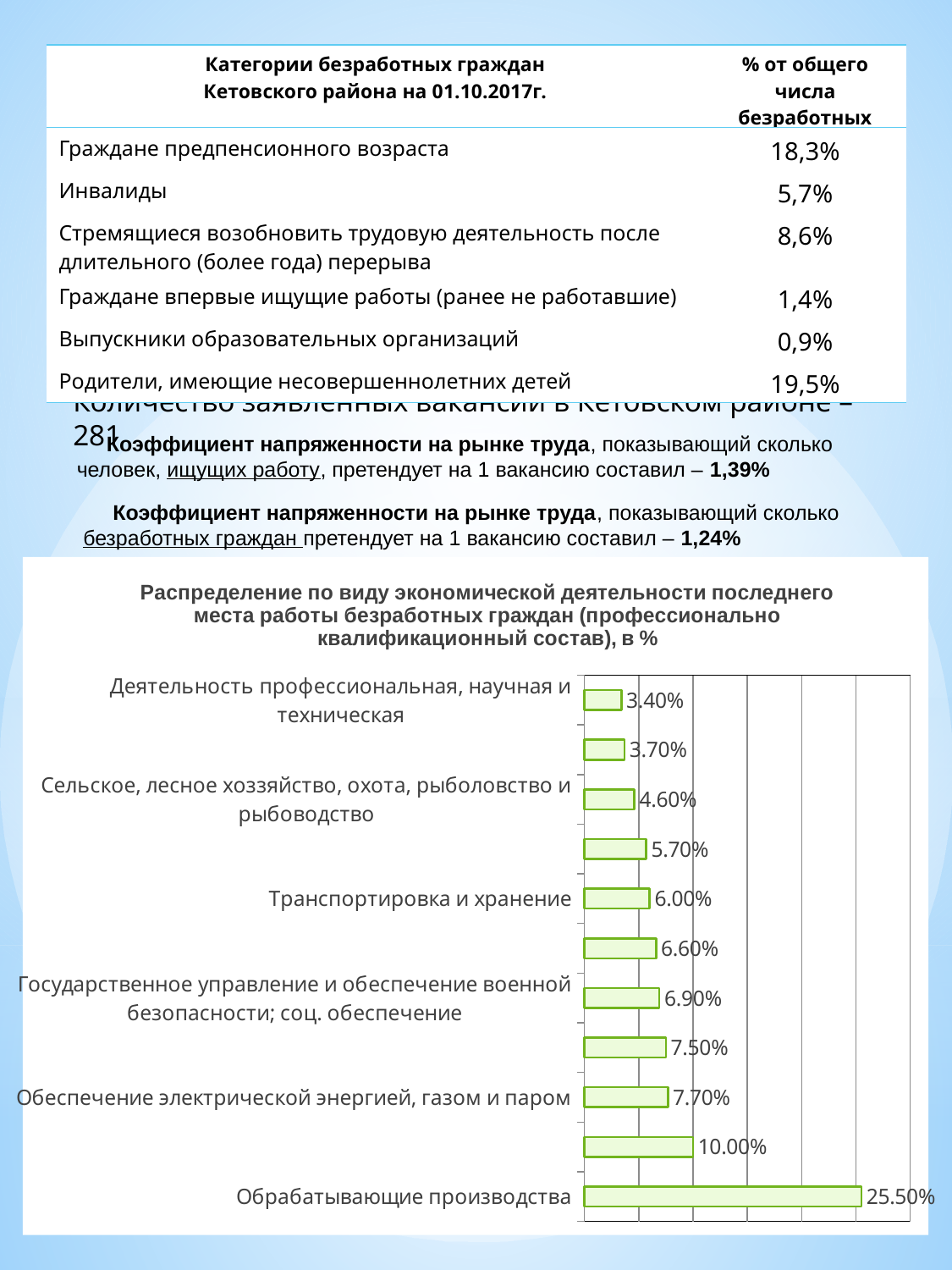
What kind of chart is shown on the slide? bar chart What is the value for Государственное управление и обеспечение военной безопасности; соц. обеспечение? 6.90% Which category has the highest value in the chart? Обрабатывающие производства What is the value for Транспортировка и хранение? 6.00% What is the value for Обрабатывающие производства? 25.50% Which category has the lowest value in the chart? Деятельность профессиональная, научная и техническая How many bars are plotted in the chart? 11 What is the value for Сельское, лесное хозяйство, охота, рыболовство и рыбоводство? 4.60% Which is larger: the value for Обеспечение электрической энергией, газом и паром or the value for Транспортировка и хранение? Обеспечение электрической энергией, газом и паром What is the difference between the values for Обрабатывающие производства and Транспортировка и хранение? 19.50% What is the value for Обеспечение электрической энергией, газом и паром? 7.70% What is the value for Деятельность профессиональная, научная и техническая? 3.40%